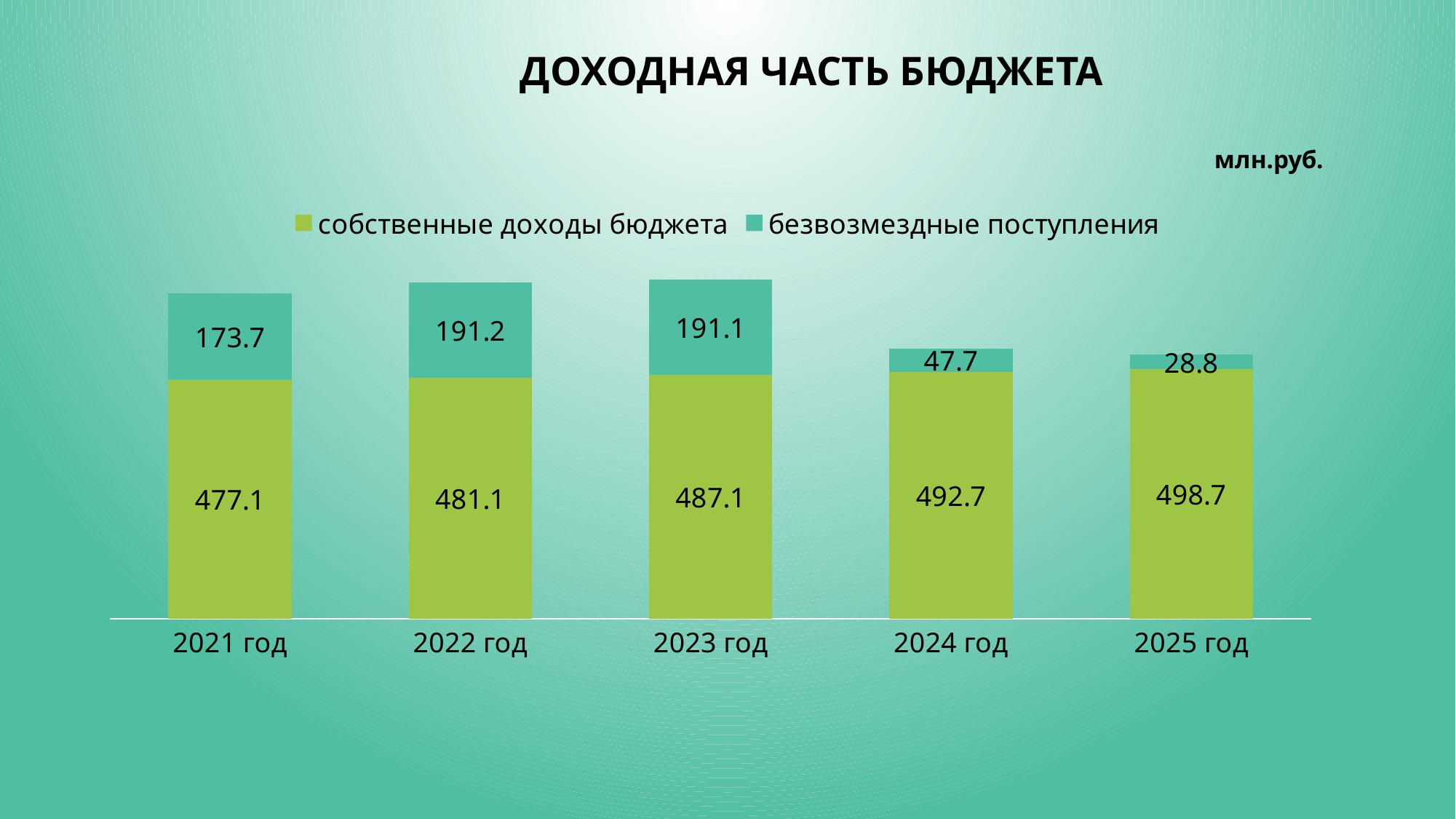
Does "собственные доходы бюджета" rise or fall from 2021 год to 2025 год? Rise What is the difference between "собственные доходы бюджета" in 2025 год and in 2021 год? 21.6 In which year is "собственные доходы бюджета" the highest? 2025 год How many series does the legend list? 2 Which is larger: "безвозмездные поступления" in 2022 год or in 2024 год? 2022 год What kind of chart is shown on the slide? Stacked bar chart What is the value of "собственные доходы бюджета" for 2023 год? 487.1 What is the total of the stacked bar for 2024 год? 540.4 How many years are shown on the x axis? 5 What is the value of "безвозмездные поступления" for 2025 год? 28.8 What is the value of "безвозмездные поступления" for 2021 год? 173.7 In which year is "безвозмездные поступления" the lowest? 2025 год